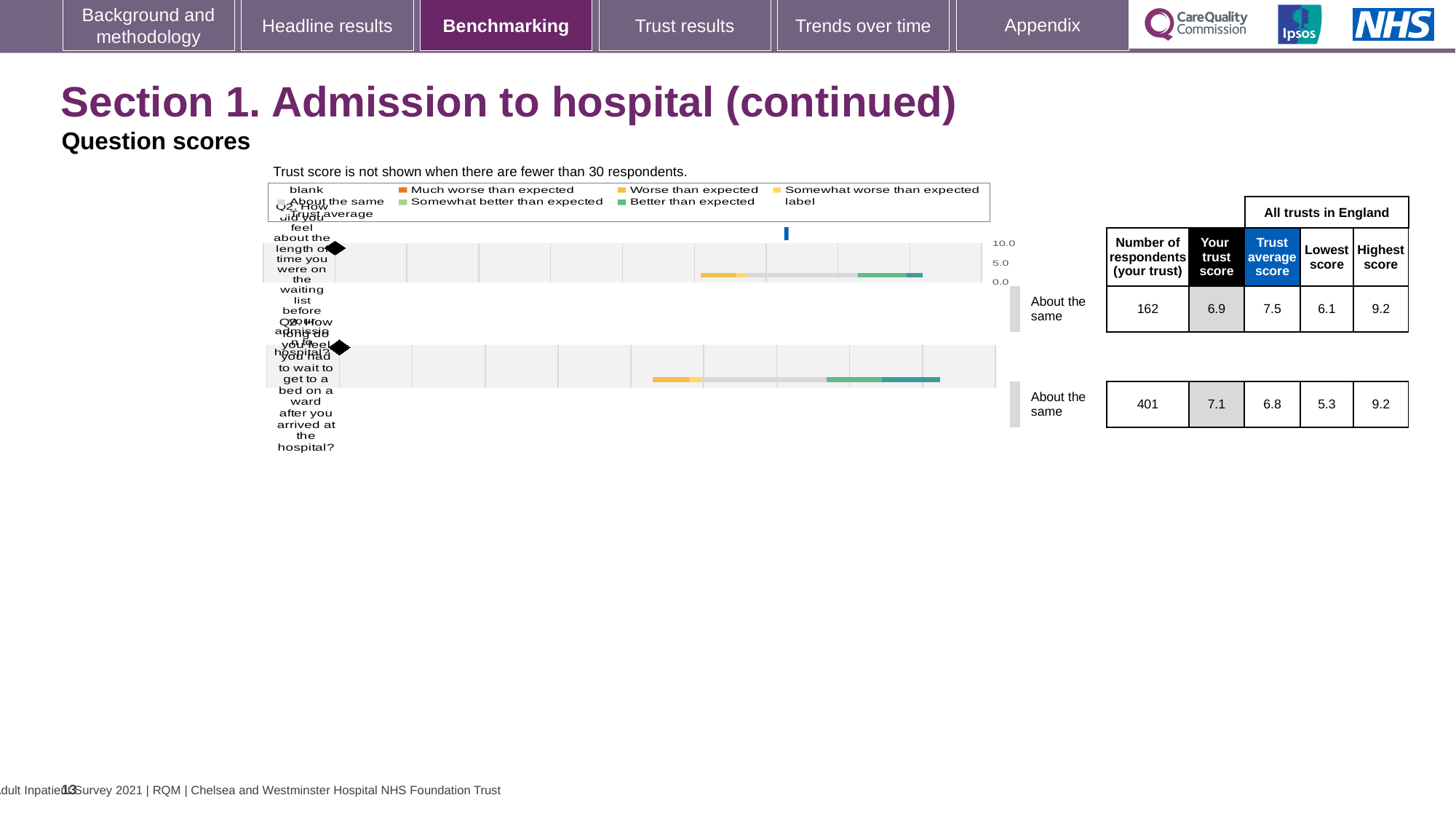
What is the difference between the highest score and the lowest score for Q2? 3.1 What is the trust score for Q3 (wait to get to a bed on a ward after arriving at the hospital)? 7.1 What kind of chart is used to show the question scores on this slide? bar chart What is the trust score for Q2 (length of time on the waiting list before admission)? 6.9 What benchmark category is shown for Q2 in the benchmarking chart? About the same Which question has the higher trust score, Q2 or Q3? Q3 What is the highest value shown on the score axis of the benchmarking chart? 10.0 What is the difference between the highest score and the lowest score for Q3? 3.9 How many respondents from the trust answered Q3? 401 How many questions are plotted in the benchmarking chart on this slide? 2 What is the trust average score across all trusts in England for Q2? 7.5 Is the trust score for Q2 greater or less than 5.0 on the chart axis? greater